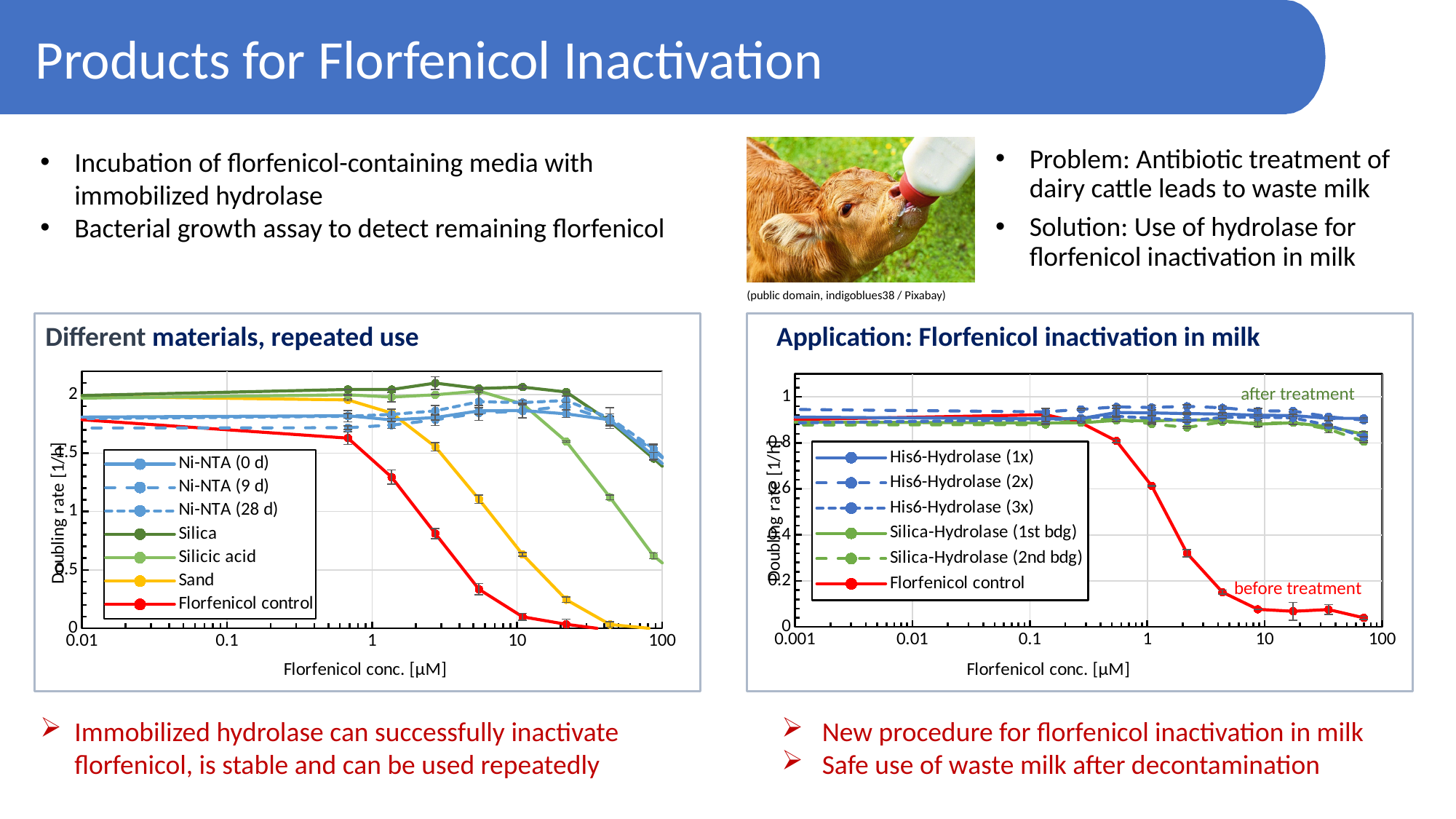
In the 'Different materials, repeated use' chart, which has the higher doubling rate at 10 µM: Silica or Florfenicol control? Silica In the 'Different materials, repeated use' chart, is the doubling rate for Sand at 10 µM greater or less than 1? less How many series does the legend of the 'Application: Florfenicol inactivation in milk' chart list? 6 In the 'Different materials, repeated use' chart, does the Florfenicol control series rise or fall as florfenicol concentration increases? fall How many series does the legend of the 'Different materials, repeated use' chart list? 7 In the 'Application: Florfenicol inactivation in milk' chart, does the Florfenicol control series rise or fall as florfenicol concentration increases? fall What kind of chart is the 'Different materials, repeated use' chart? line chart In the 'Application: Florfenicol inactivation in milk' chart, is the doubling rate for Florfenicol control at 10 µM greater or less than 0.2? less In the 'Application: Florfenicol inactivation in milk' chart, which has the lower doubling rate at 1 µM: Florfenicol control or Silica-Hydrolase (1st bdg)? Florfenicol control What colour is the Florfenicol control line in the 'Application: Florfenicol inactivation in milk' chart? red In the 'Application: Florfenicol inactivation in milk' chart, is the doubling rate for His6-Hydrolase (1x) at 10 µM greater or less than 0.8? greater What is the x-axis label of the 'Different materials, repeated use' chart? Florfenicol conc. [µM]